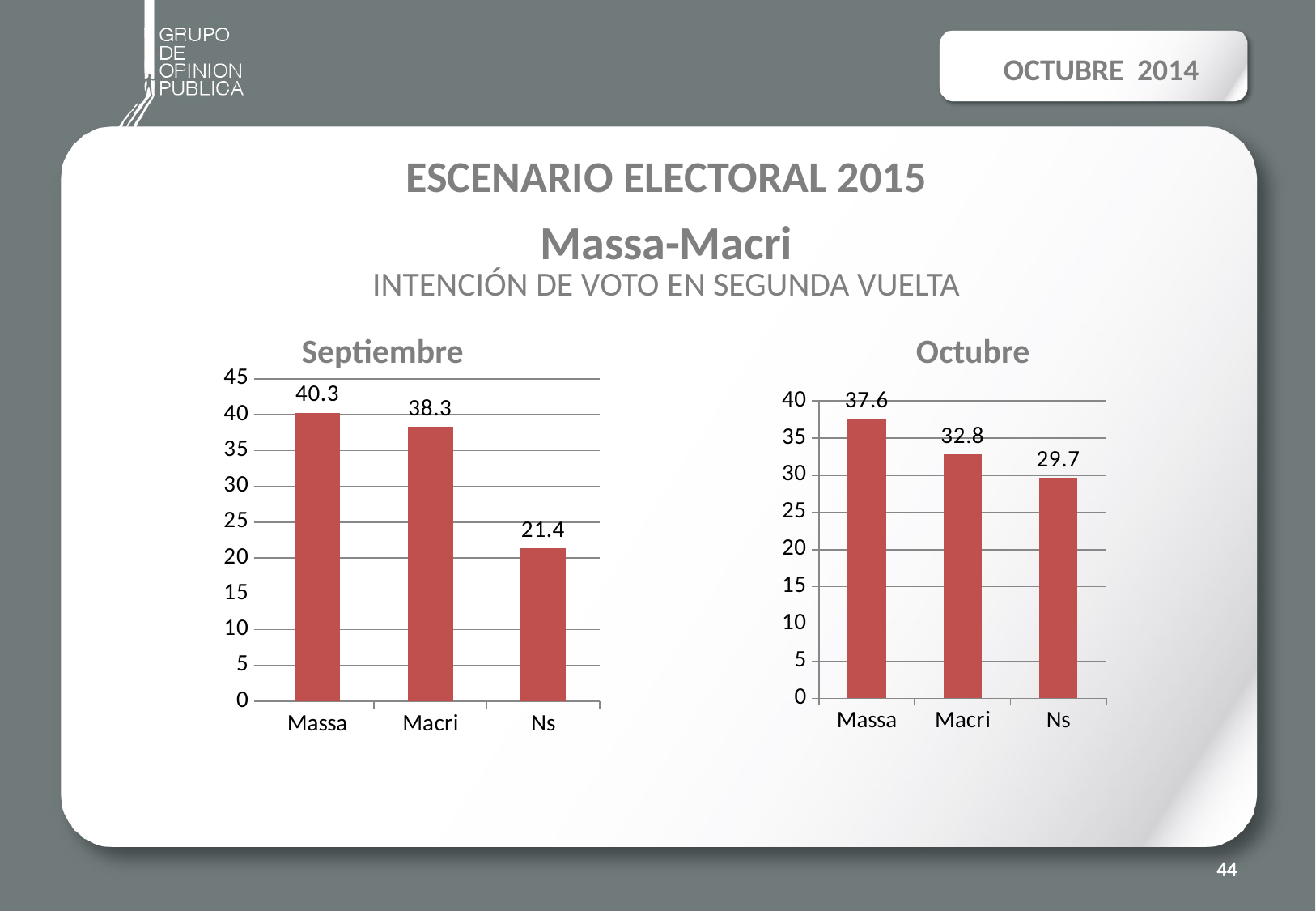
How many categories are shown in the Septiembre chart? 3 In the Septiembre chart, what is the difference between the values for Massa and Macri? 2.0 In the Octubre chart, what is the difference between the values for Massa and Ns? 7.9 In the Octubre chart, is the value for Ns greater or less than 25? greater In the Octubre chart, what is the value for Macri? 32.8 In the Octubre chart, which category has the highest value? Massa What kind of chart is the Octubre chart? bar chart What is the title of the chart on the left side of the slide? Septiembre In the Septiembre chart, what is the value for Massa? 40.3 In the Octubre chart, what is the value for Ns? 29.7 In the Septiembre chart, which is larger, the value for Macri or the value for Ns? Macri In the Septiembre chart, which category has the lowest value? Ns